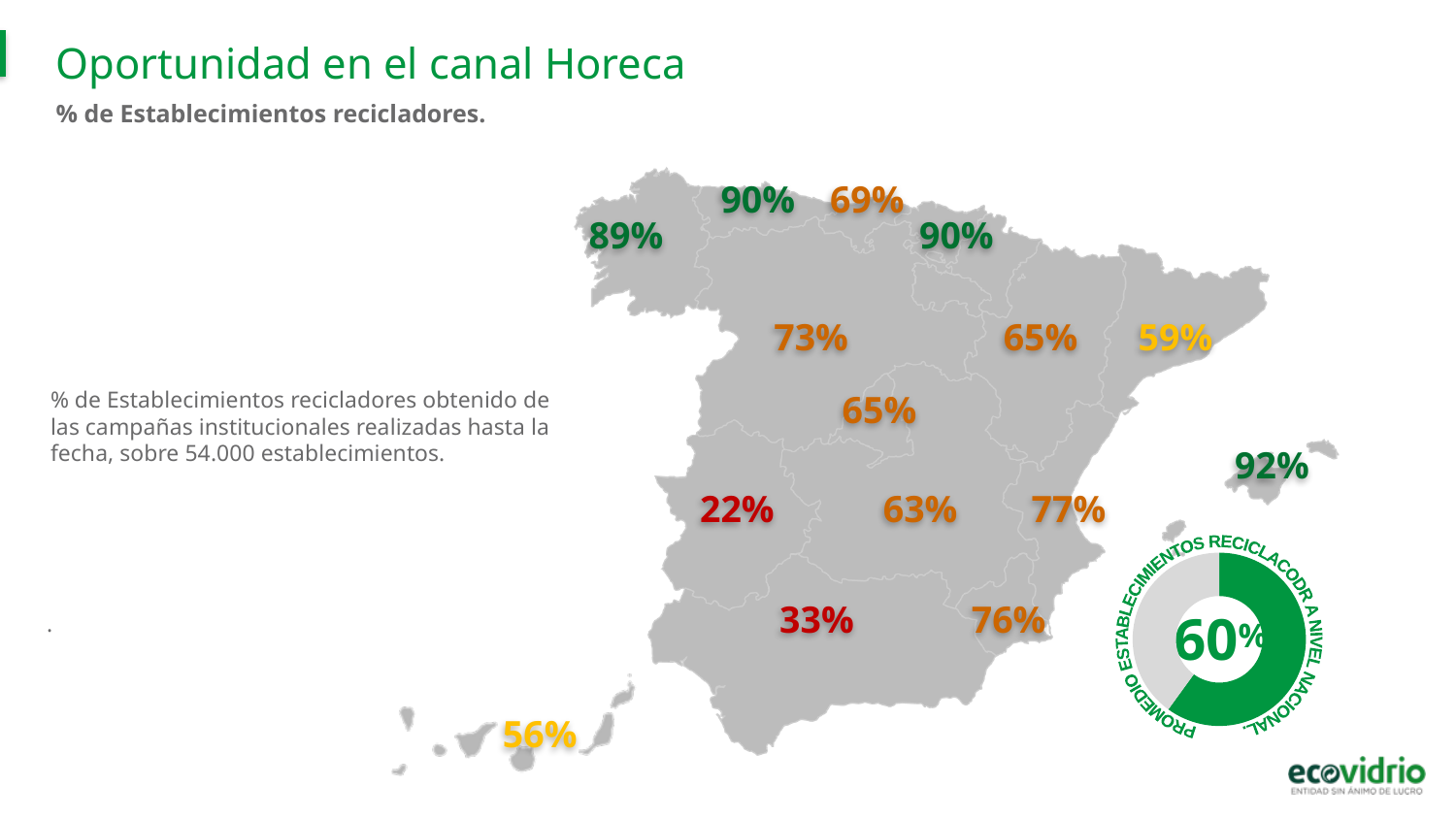
What kind of chart is the one at the bottom right of the slide showing 60%? Donut (pie) chart What is the difference between the national average in the donut chart (60%) and the lowest map value (22%)? 38 percentage points What percentage is shown on the islands to the right (east) of the mainland on the map? 92% What does the label around the donut chart say the 60% represents? Promedio establecimientos recicladores a nivel nacional On the map of Spain, what is the lowest percentage shown? 22% What value does the donut chart at the bottom right of the slide show? 60% How many percentage values on the map are printed in red? 2 How many percentage values are printed on the map of Spain? 15 What is the difference between the highest (92%) and lowest (22%) percentages on the map? 70 percentage points What percentage is shown on the islands at the bottom left of the map? 56% On the map of Spain, what is the highest percentage shown? 92% Which is larger: the national average shown in the donut chart or the highest value on the map? The highest value on the map (92%)